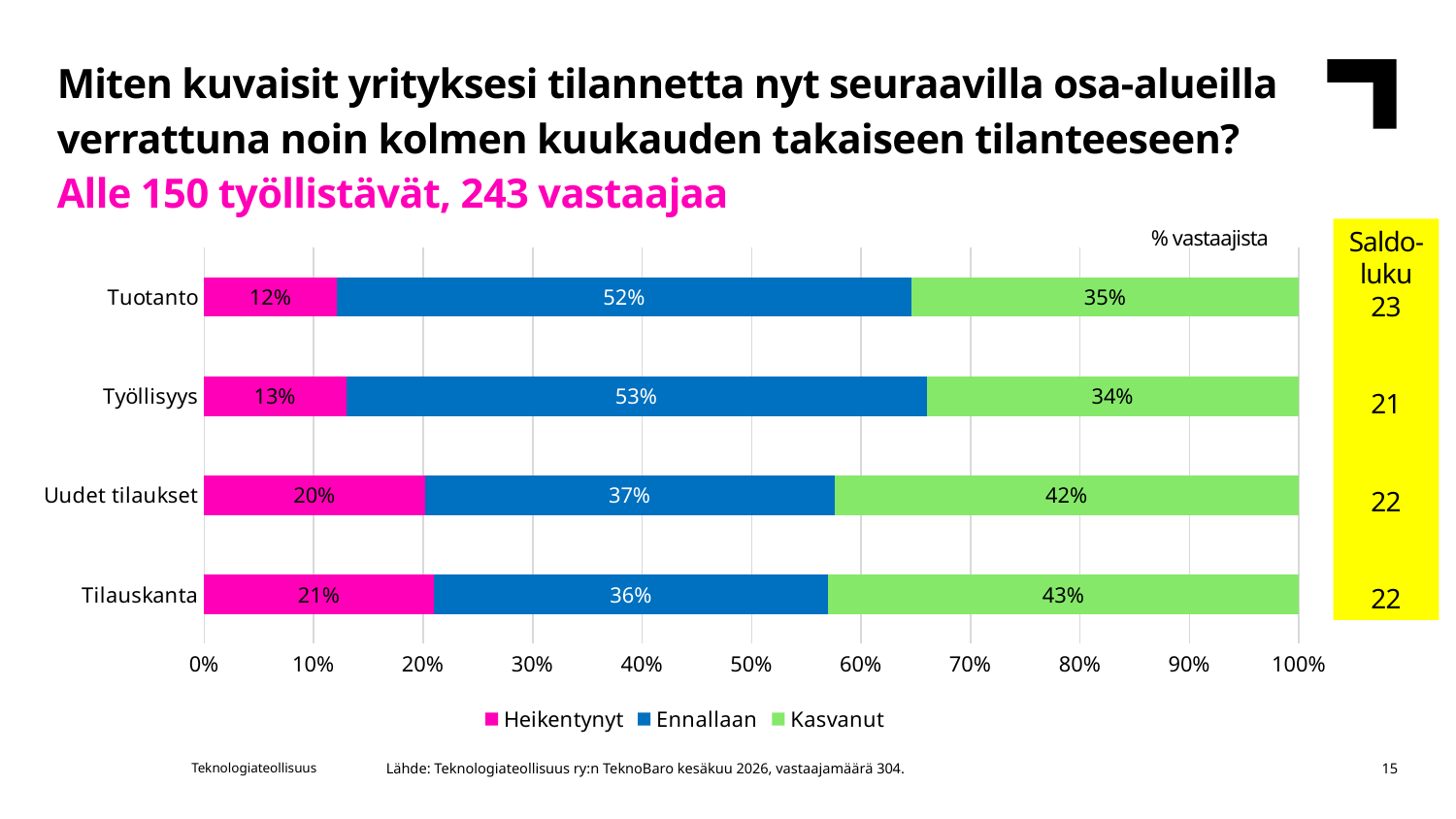
Which category has the highest "Kasvanut" share? Tilauskanta Which is larger: the "Kasvanut" value for Uudet tilaukset or the "Kasvanut" value for Tuotanto? Uudet tilaukset Which category has the lowest "Heikentynyt" share? Tuotanto Which colour represents "Heikentynyt" in the legend? Pink (magenta) What kind of chart is shown on the slide? Stacked bar chart How many series does the legend list? 3 What is the difference between the "Ennallaan" values for Työllisyys and Tilauskanta? 17 percentage points What percentage of respondents answered "Ennallaan" for Tuotanto? 52% What is the "Kasvanut" value for Tilauskanta? 43% How many categories are shown on the chart? 4 What is the saldoluku (balance figure) shown for Tuotanto? 23 What is the "Heikentynyt" value for Uudet tilaukset? 20%